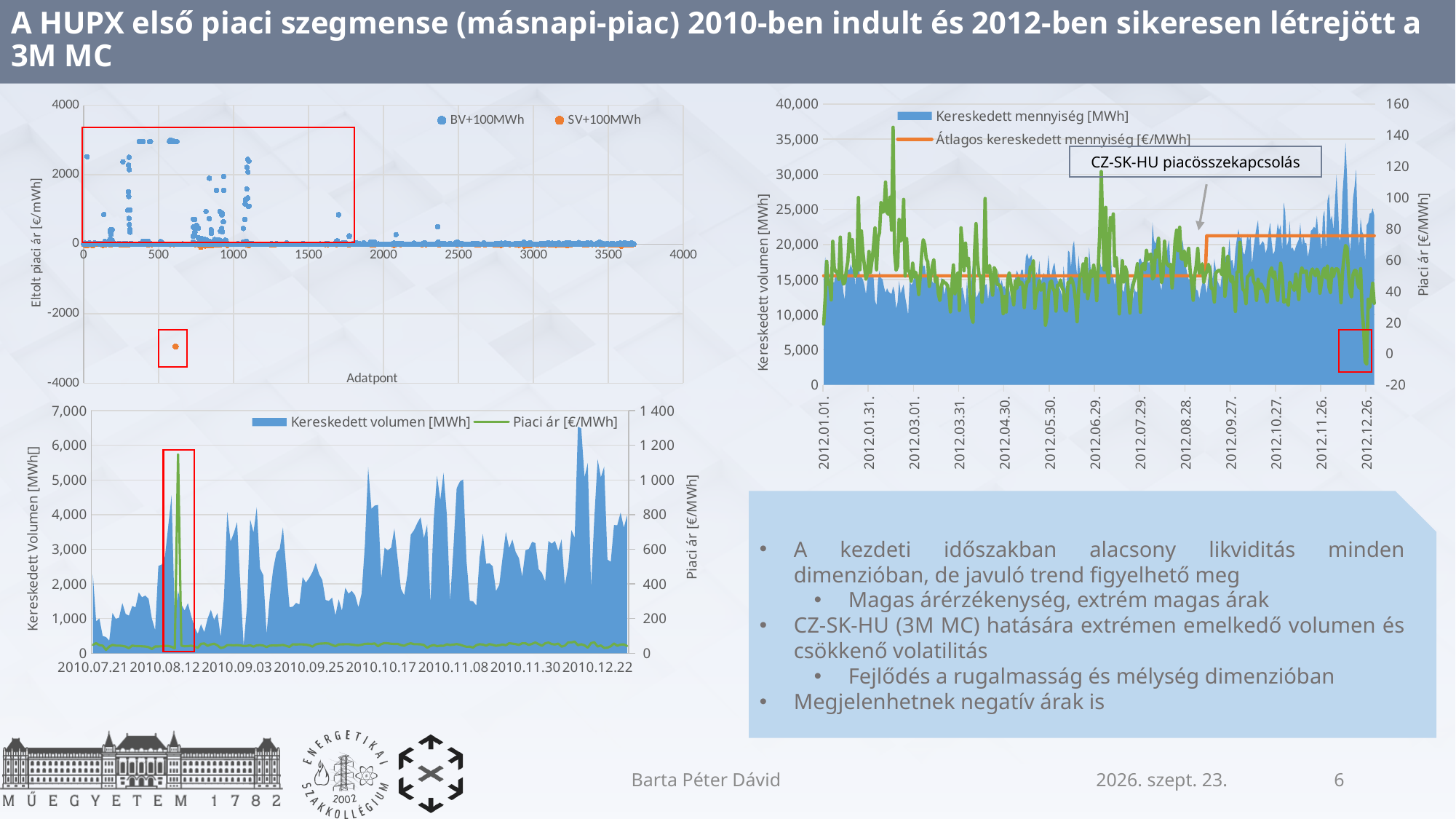
In the bottom-left chart, is the highest value of Piaci ár [€/MWh] greater or less than 1 000? greater In the top-left scatter chart, is the lowest SV+100MWh point greater or less than -2000? less What is the first date label on the x-axis of the bottom-left chart? 2010.07.21 In the top-right chart, does the orange Átlagos kereskedett mennyiség line rise or fall after the CZ-SK-HU piacösszekapcsolás annotation? rise How many series does the legend of the top-left scatter chart list? 2 What is the y-axis title of the top-left scatter chart? Eltolt piaci ár [€/mWh] How many series does the legend of the bottom-left chart list? 2 In the top-right chart, is the orange line's value at 2012.12.26 greater or less than 60? greater What kind of chart is the top-left chart with the x-axis title 'Adatpont'? scatter chart How many series does the legend of the top-right chart list? 2